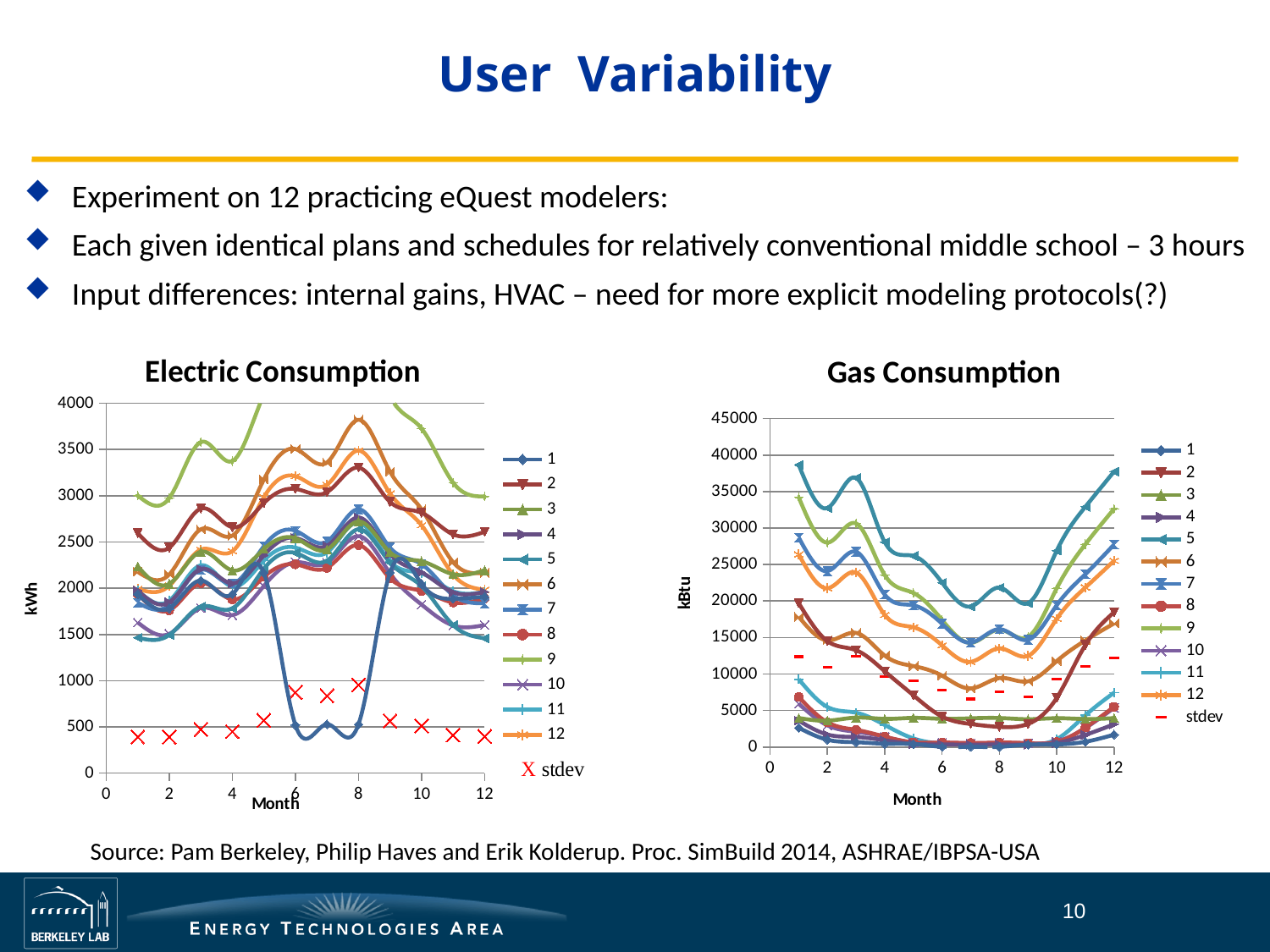
In the Electric Consumption chart, is the value for series 2 at month 8 greater or less than 3000? greater In the Gas Consumption chart, is the value for series 5 at month 1 greater or less than 35000? greater In the Gas Consumption chart, does series 5 rise or fall from month 1 to month 7? fall In the Electric Consumption chart, which series has the lowest value at month 6? 1 In the Gas Consumption chart, which is larger at month 3: series 5 or series 7? series 5 How many entries does the legend of the Electric Consumption chart list? 12 In the Electric Consumption chart, is the value for series 1 at month 6 greater or less than 1000? less In the Gas Consumption chart, which series has the highest value at month 1? 5 What kind of chart is the Electric Consumption chart? line chart How many entries does the legend of the Gas Consumption chart list? 13 What kind of chart is the Gas Consumption chart? line chart What is the y-axis label of the Gas Consumption chart? kBtu